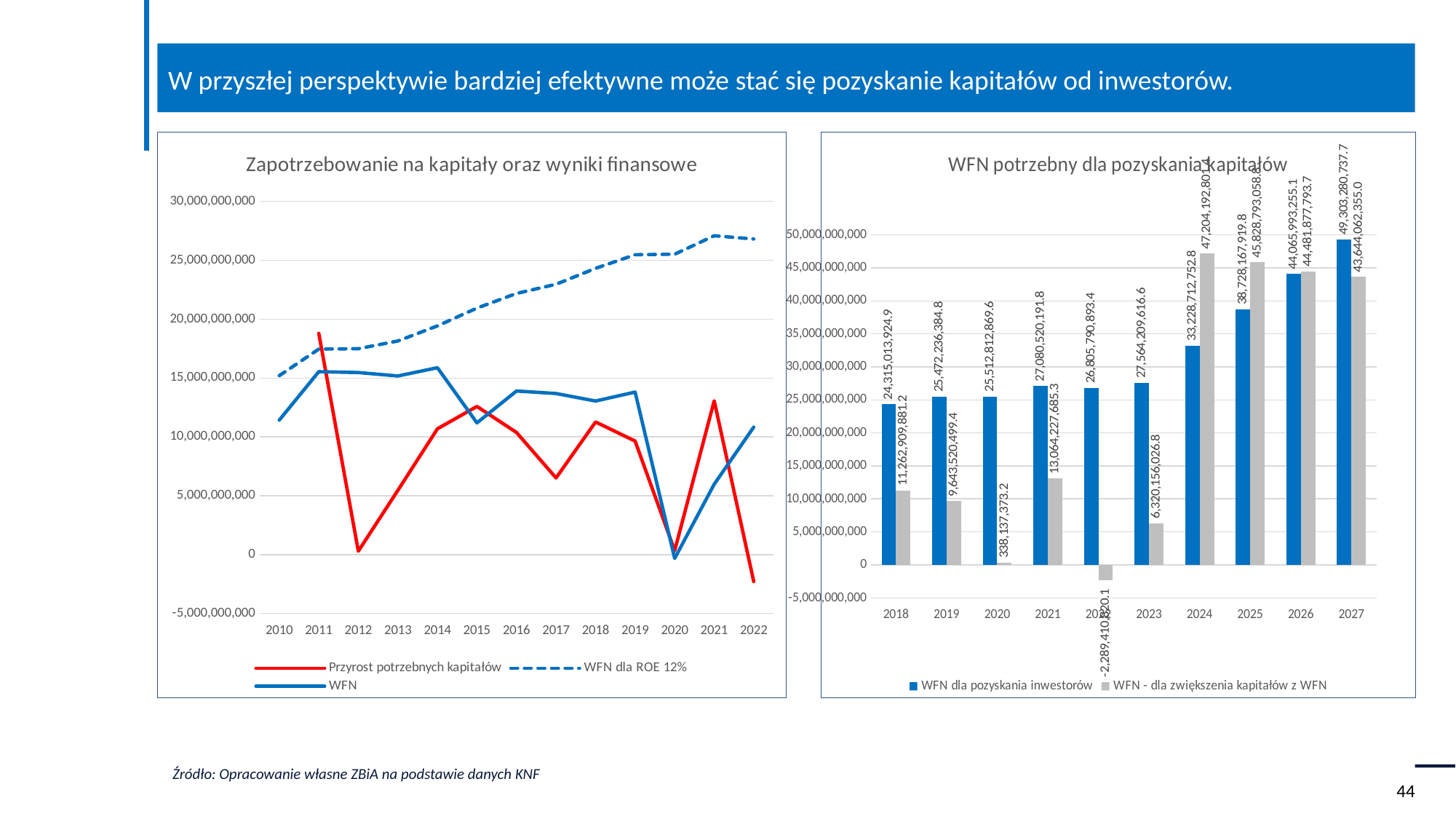
In the right-hand chart 'WFN potrzebny dla pozyskania kapitałów', which year has the lowest value for 'WFN - dla zwiększenia kapitałów z WFN'? 2022 In the right-hand chart 'WFN potrzebny dla pozyskania kapitałów', what is the difference between 'WFN dla pozyskania inwestorów' and 'WFN - dla zwiększenia kapitałów z WFN' in 2027? 5,659,218,382.7 In the right-hand chart 'WFN potrzebny dla pozyskania kapitałów', how many series does the legend list? 2 What kind of chart is the right-hand chart titled 'WFN potrzebny dla pozyskania kapitałów'? bar chart How many years are shown on the x axis of the right-hand chart 'WFN potrzebny dla pozyskania kapitałów'? 10 What kind of chart is the left-hand chart titled 'Zapotrzebowanie na kapitały oraz wyniki finansowe'? line chart In the right-hand chart 'WFN potrzebny dla pozyskania kapitałów', what is the value of 'WFN - dla zwiększenia kapitałów z WFN' for 2020? 338,137,373.2 In the right-hand chart 'WFN potrzebny dla pozyskania kapitałów', what is the value of 'WFN dla pozyskania inwestorów' for 2027? 49,303,280,737.7 In the right-hand chart 'WFN potrzebny dla pozyskania kapitałów', which series has the larger value in 2025: 'WFN dla pozyskania inwestorów' or 'WFN - dla zwiększenia kapitałów z WFN'? WFN - dla zwiększenia kapitałów z WFN In the right-hand chart 'WFN potrzebny dla pozyskania kapitałów', which year has the highest value for 'WFN dla pozyskania inwestorów'? 2027 In the left-hand chart 'Zapotrzebowanie na kapitały oraz wyniki finansowe', how many series does the legend list? 3 In the left-hand chart 'Zapotrzebowanie na kapitały oraz wyniki finansowe', is the value of 'WFN dla ROE 12%' in 2021 greater or less than 25,000,000,000? greater